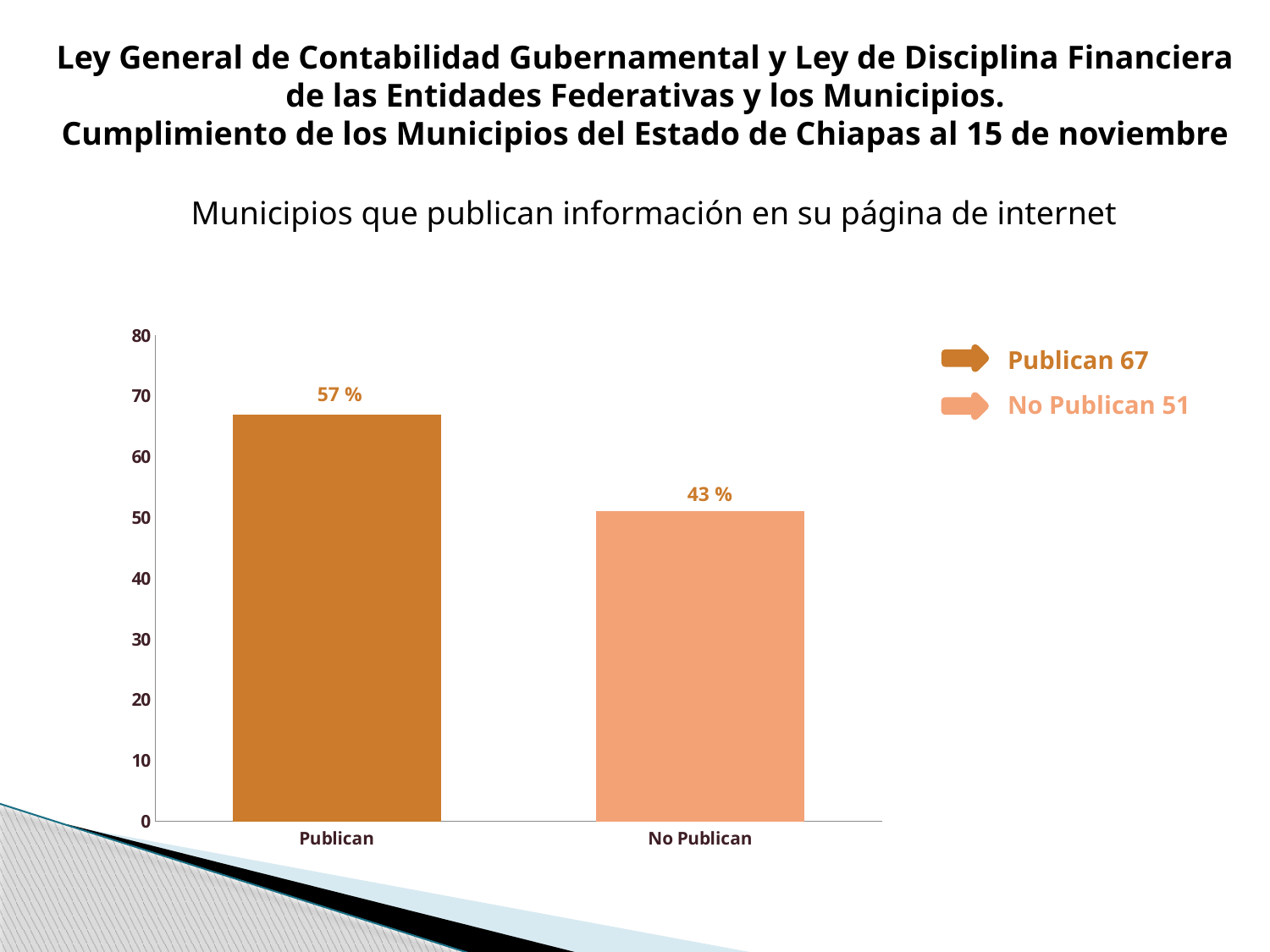
Which category has the shorter bar? No Publican What is the difference in percentage points between the Publican and No Publican labels? 14 What percentage label is shown above the No Publican bar? 43 % According to the legend, how many municipalities are in the No Publican category? 51 What kind of chart is shown on the slide? Bar chart According to the legend, how many municipalities are in the Publican category? 67 What is the difference between the Publican count (67) and the No Publican count (51) shown in the legend? 16 What percentage label is shown above the Publican bar? 57 % Is the value for Publican greater or less than 60? greater Is the value for No Publican greater or less than 60? less Which category has the taller bar? Publican How many categories are shown on the x axis? 2